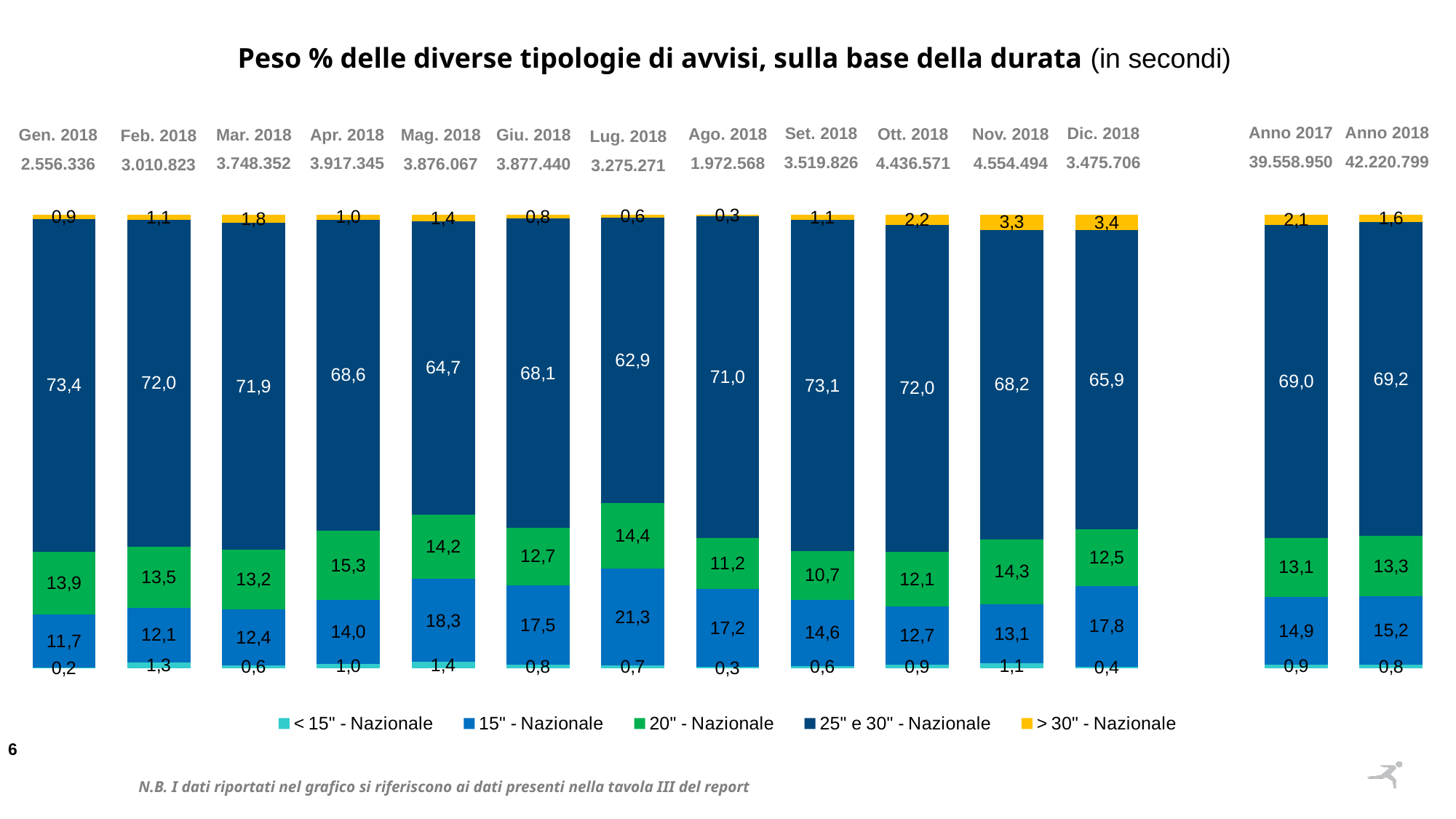
What is the value of the > 30" - Nazionale series for Dic. 2018? 3,4 Which category has the highest value for the 15" - Nazionale series? Lug. 2018 What is the value of the 25" e 30" - Nazionale series for Gen. 2018? 73,4 What is the difference between the 25" e 30" - Nazionale values for Gen. 2018 and Lug. 2018? 10,5 Which has the larger 20" - Nazionale value, Mag. 2018 or Giu. 2018? Mag. 2018 Which category has the lowest value for the 25" e 30" - Nazionale series? Lug. 2018 How many series does the legend list? 5 What is the value of the 15" - Nazionale series for Lug. 2018? 21,3 What is the value of the 20" - Nazionale series for Apr. 2018? 15,3 What is the difference between the 15" - Nazionale values for Anno 2018 and Anno 2017? 0,3 What kind of chart is shown on the slide? Stacked bar chart How many bars are shown in the chart? 14